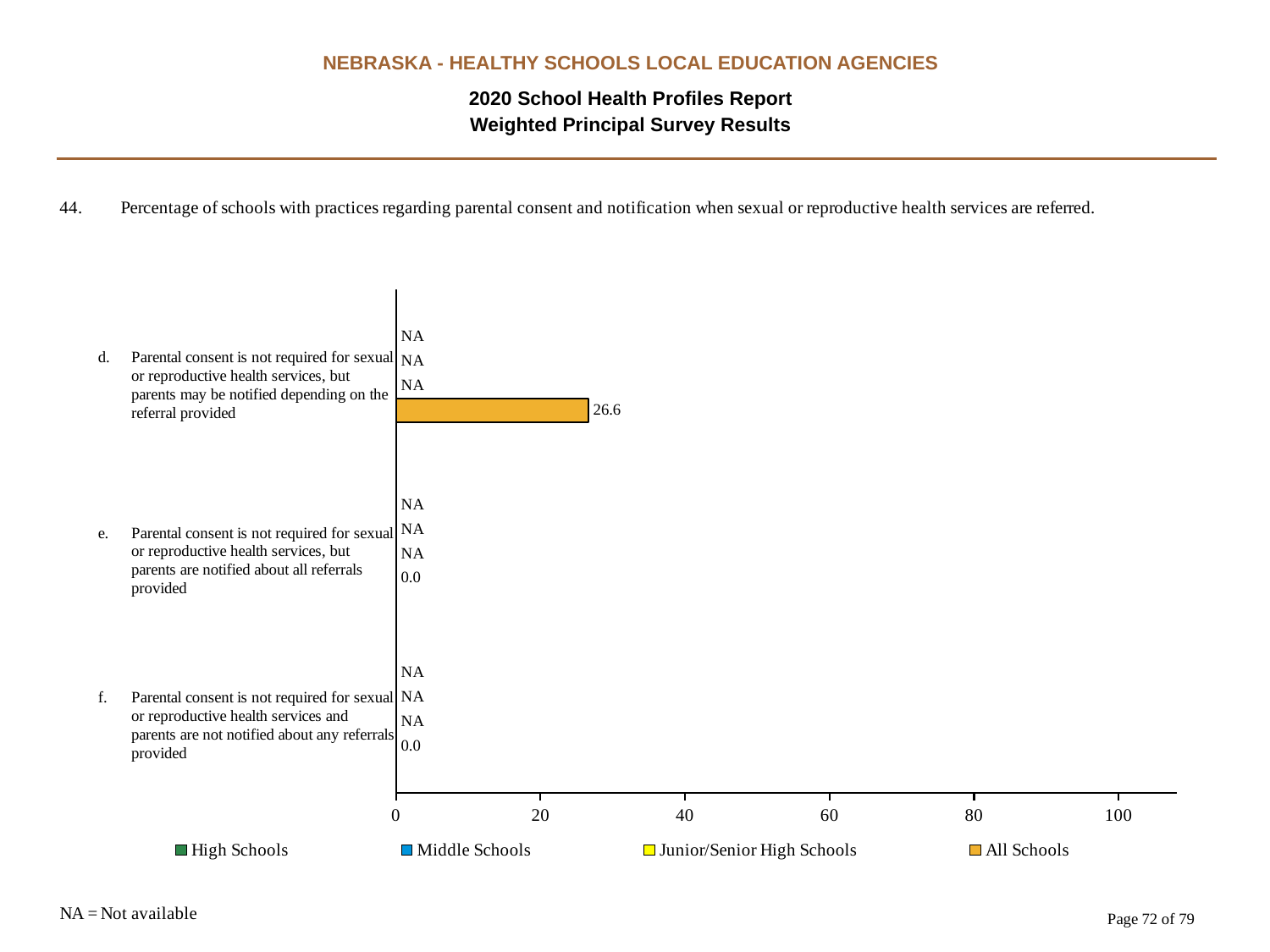
What kind of chart is shown on the slide? Bar chart Is the All Schools value for item d greater or less than 40? less What is the difference between the All Schools values for item d and item e? 26.6 What is shown for Middle Schools for item f? NA How many series does the legend list? 4 What is shown for High Schools for item d? NA How many items (categories) are plotted on the chart? 3 What is the value for All Schools for item d (parental consent not required, but parents may be notified depending on the referral provided)? 26.6 What is the value for All Schools for item e (parents are notified about all referrals provided)? 0.0 Which item has the highest value for All Schools? d. Parental consent is not required for sexual or reproductive health services, but parents may be notified depending on the referral provided Is the All Schools value for item d greater or less than 20? greater What is the value for All Schools for item f (parents are not notified about any referrals provided)? 0.0